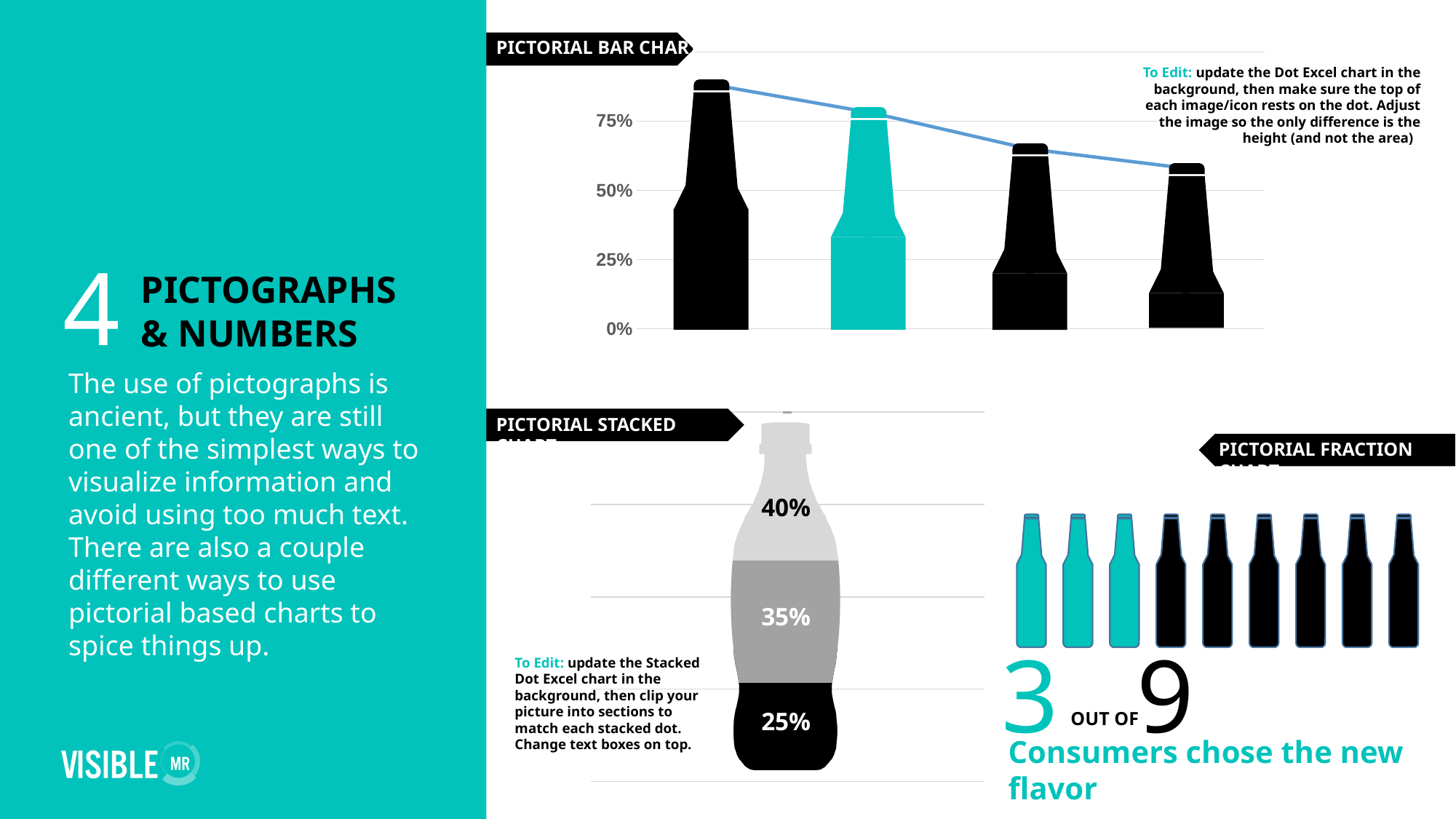
In the Pictorial Fraction Chart, how many bottles are shown in total? 9 In the Pictorial Bar Chart at the top right, is the value of the third bottle from the left greater or less than 50%? greater In the Pictorial Bar Chart at the top right, is the value of the rightmost bottle greater or less than 75%? less In the Pictorial Bar Chart at the top right, which bottle is the tallest? the leftmost bottle In the Pictorial Stacked Chart, what percentage is shown in the top (light grey) section of the bottle? 40% In the Pictorial Bar Chart at the top right, is the value of the leftmost bottle greater or less than 75%? greater In the Pictorial Stacked Chart, what is the difference between the 40% section and the 35% section? 5% In the Pictorial Bar Chart at the top right, which bottle is the shortest? the rightmost bottle In the Pictorial Bar Chart at the top right, how many bottles (bars) are plotted? 4 In the Pictorial Bar Chart at the top right, which bottle is coloured teal rather than black? the second bottle from the left In the Pictorial Bar Chart at the top right, do the values rise or fall from left to right? fall In the Pictorial Stacked Chart, what percentage is shown in the bottom (black) section of the bottle? 25%